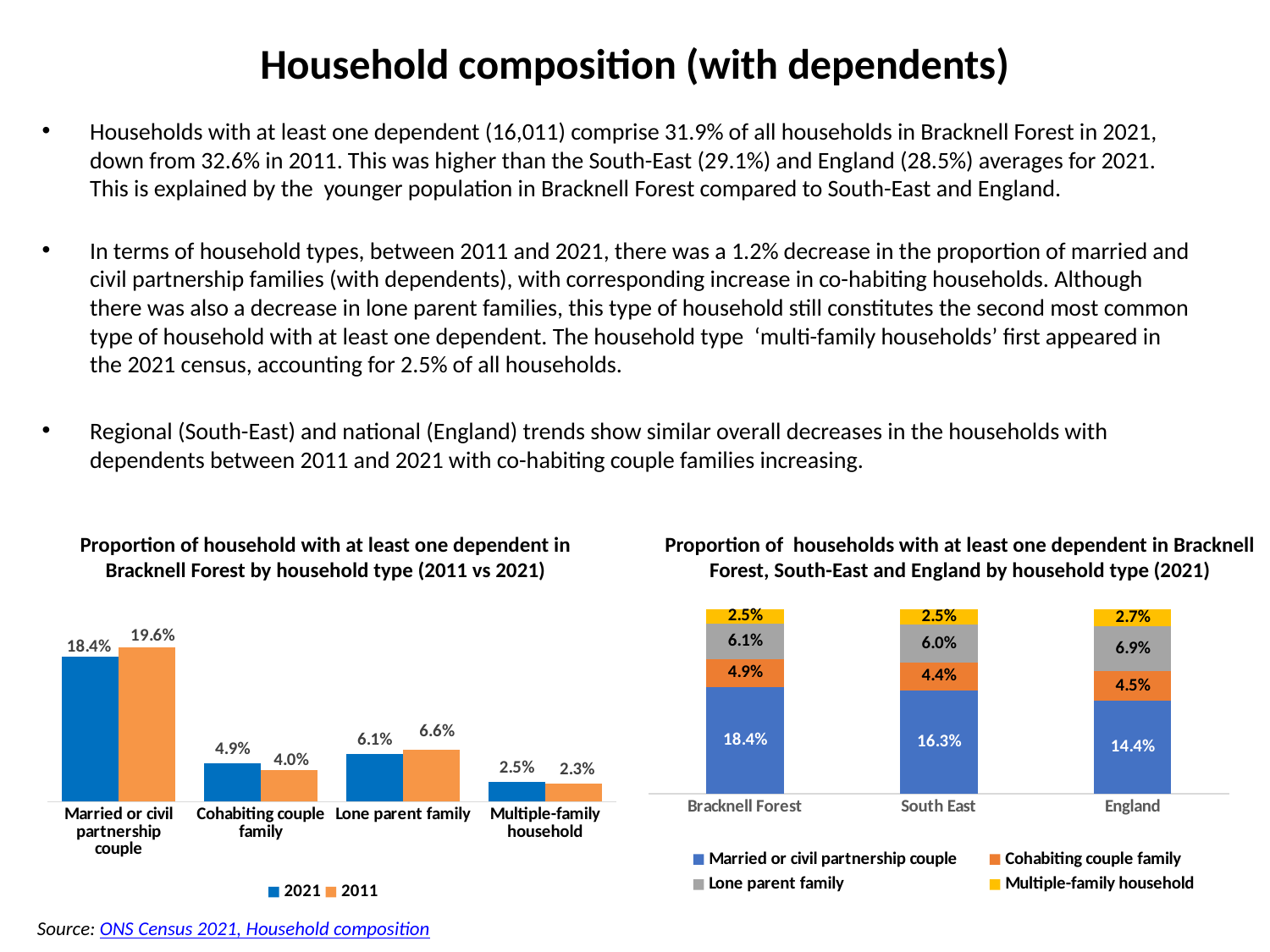
In the left chart (Bracknell Forest 2011 vs 2021), what is the 2021 value for Cohabiting couple family? 4.9% In the left chart (Bracknell Forest 2011 vs 2021), is the Lone parent family value larger in 2021 or 2011? 2011 In the right chart (Bracknell Forest, South-East and England), which area has the lowest Married or civil partnership couple value? England In the right chart (Bracknell Forest, South-East and England), how many areas are shown on the x axis? 3 In the left chart (Bracknell Forest 2011 vs 2021), which household type has the lowest 2011 value? Multiple-family household In the left chart (Bracknell Forest 2011 vs 2021), what is the 2011 value for Married or civil partnership couple? 19.6% What kind of chart is the right chart (Bracknell Forest, South-East and England by household type)? Stacked bar chart In the left chart (Bracknell Forest 2011 vs 2021), how many series does the legend list? 2 In the right chart (Bracknell Forest, South-East and England), what is the Lone parent family value for England? 6.9% In the left chart (Bracknell Forest 2011 vs 2021), which household type has the highest 2021 value? Married or civil partnership couple In the right chart (Bracknell Forest, South-East and England), what is the total of the stacked bar for Bracknell Forest? 31.9% In the left chart (Bracknell Forest 2011 vs 2021), what is the difference between the 2011 and 2021 values for Married or civil partnership couple? 1.2%